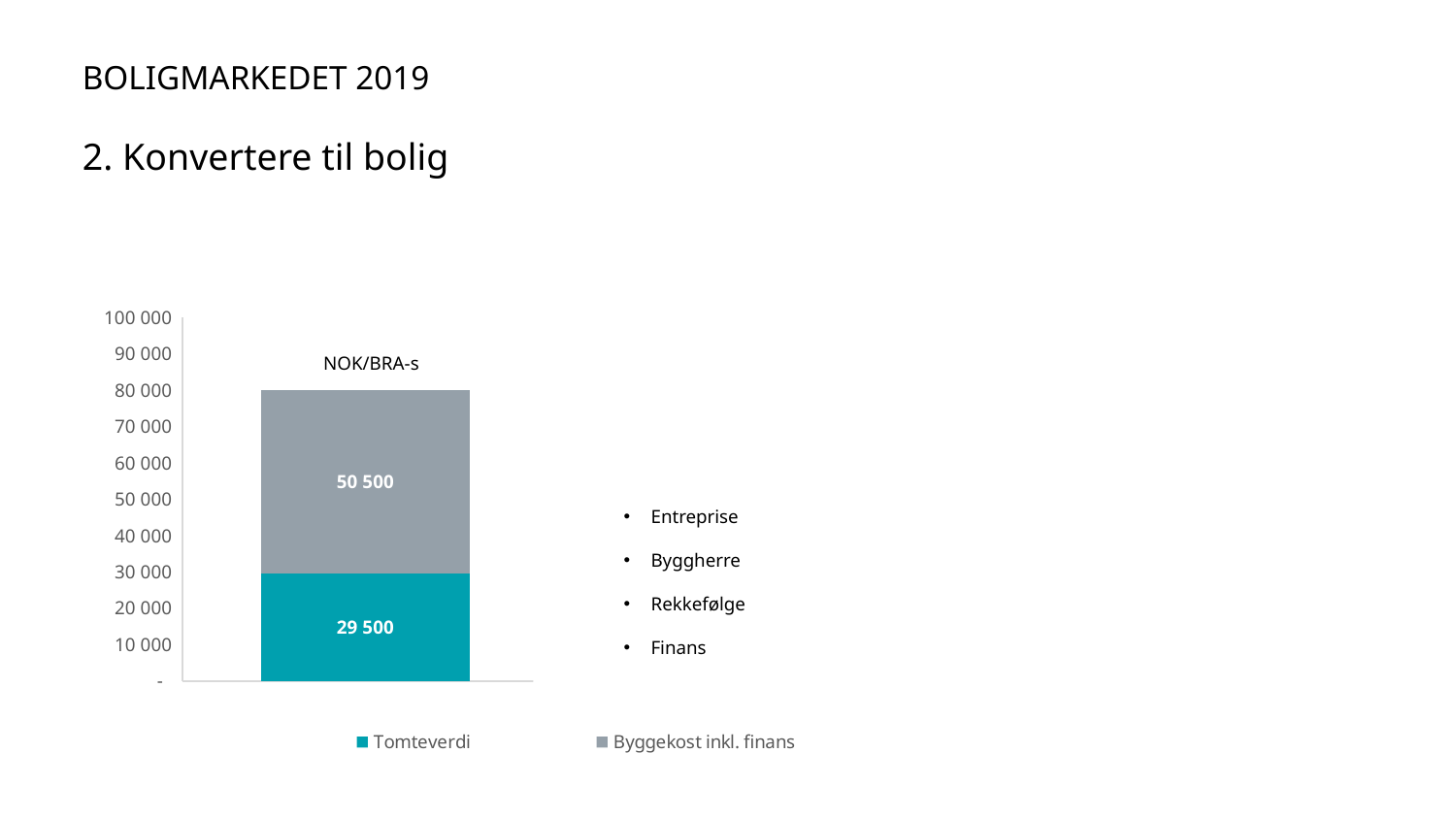
What is the total height of the stacked bar (Tomteverdi plus Byggekost inkl. finans)? 80 000 What is the difference between the Byggekost inkl. finans value and the Tomteverdi value? 21 000 Which series has the smallest value in the stacked bar? Tomteverdi What unit label is printed above the bar in the chart? NOK/BRA-s Which series has the largest value in the stacked bar? Byggekost inkl. finans Which segment is larger, Tomteverdi or Byggekost inkl. finans? Byggekost inkl. finans What is the value of the Byggekost inkl. finans segment in the stacked bar? 50 500 How many series does the legend list? 2 Is the total height of the stacked bar greater or less than 90 000? less Is the Tomteverdi value greater or less than 20 000? greater What kind of chart is shown on the slide? Stacked bar chart What is the value of the Tomteverdi segment in the stacked bar? 29 500